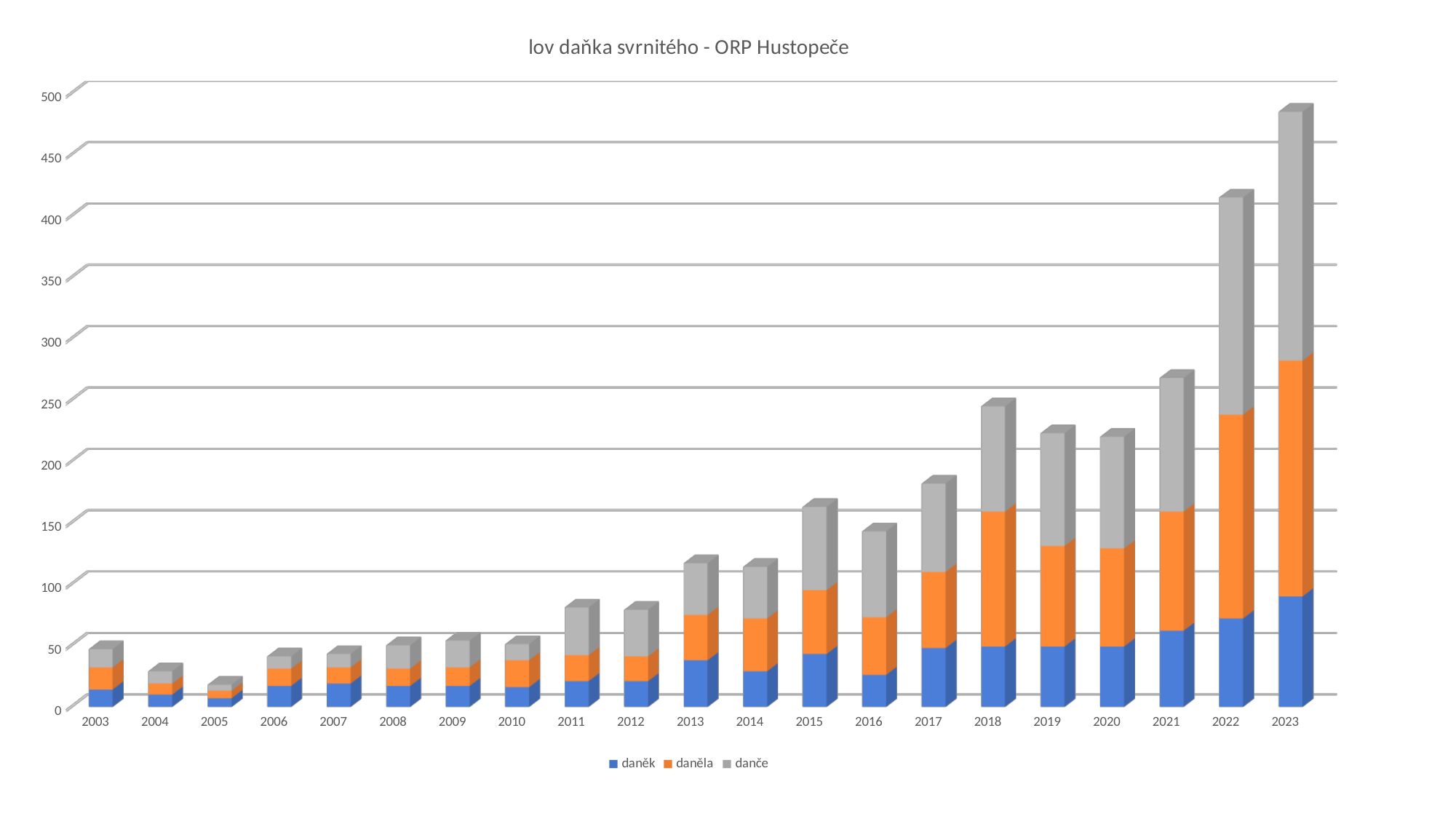
What kind of chart is shown on the slide? stacked bar chart Is the total value for 2023 greater or less than 450? greater Which year has the highest total bar? 2023 What is the title of the chart? lov daňka svrnitého - ORP Hustopeče Do the total values generally rise or fall from 2003 to 2023? rise Is the total value for 2021 greater or less than 250? greater Which series are listed in the legend? daněk, daněla, danče Which year has the larger total bar, 2021 or 2022? 2022 How many years are shown on the x axis? 21 Is the total value for 2005 greater or less than 50? less How many series does the legend list? 3 Which year has the lowest total bar? 2005